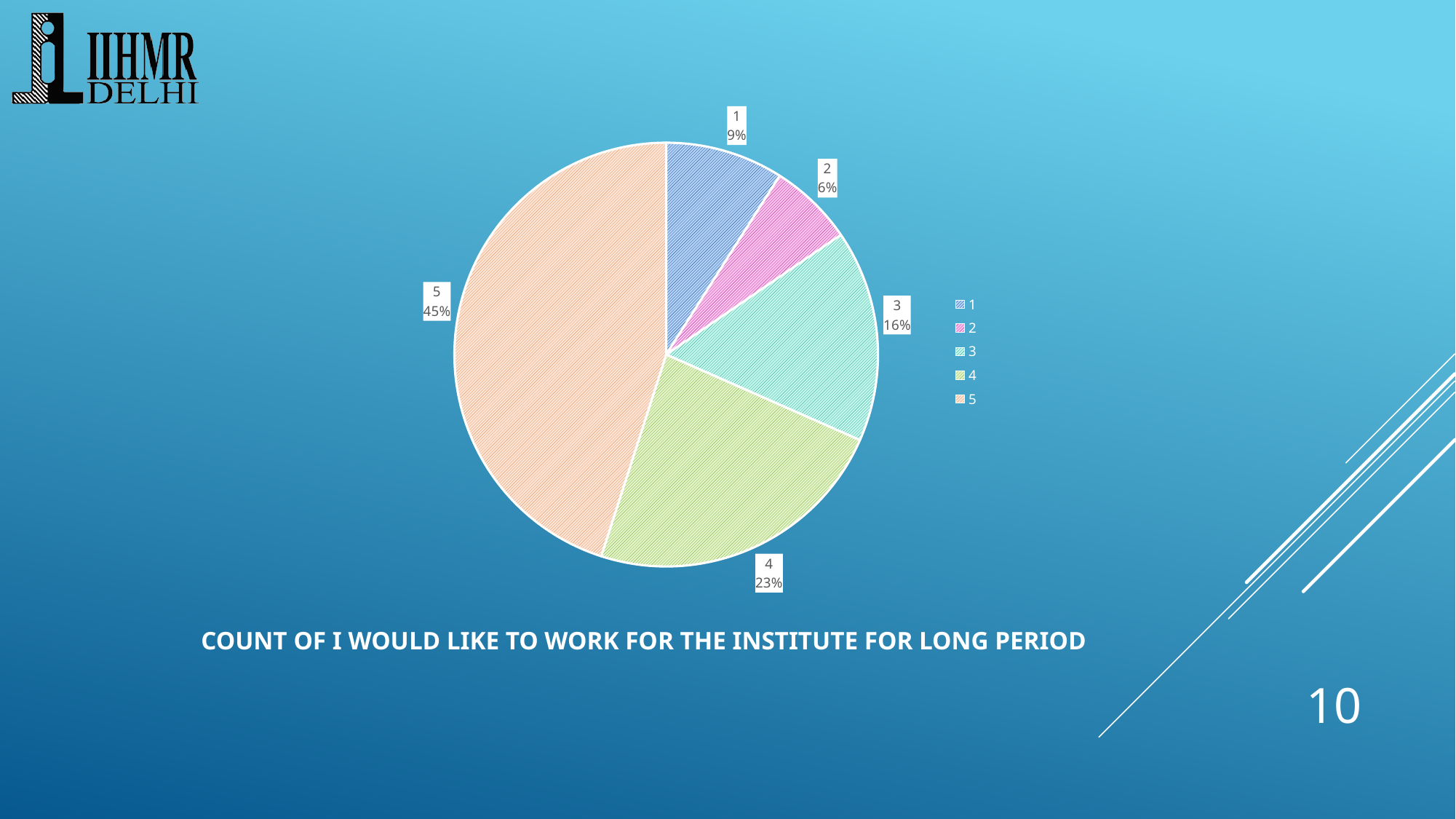
What kind of chart is shown on the slide? pie chart What is the title of the chart? COUNT OF I WOULD LIKE TO WORK FOR THE INSTITUTE FOR LONG PERIOD What percentage share does category 2 have? 6% What percentage share does category 1 have? 9% Which category has the smallest slice of the pie? 2 Which category has the largest slice of the pie? 5 How many categories does the legend list? 5 Which is larger, the share for category 3 or the share for category 1? 3 What percentage share does category 5 have? 45% What percentage share does category 4 have? 23% What percentage share does category 3 have? 16% What is the difference in percentage points between category 5 and category 4? 22